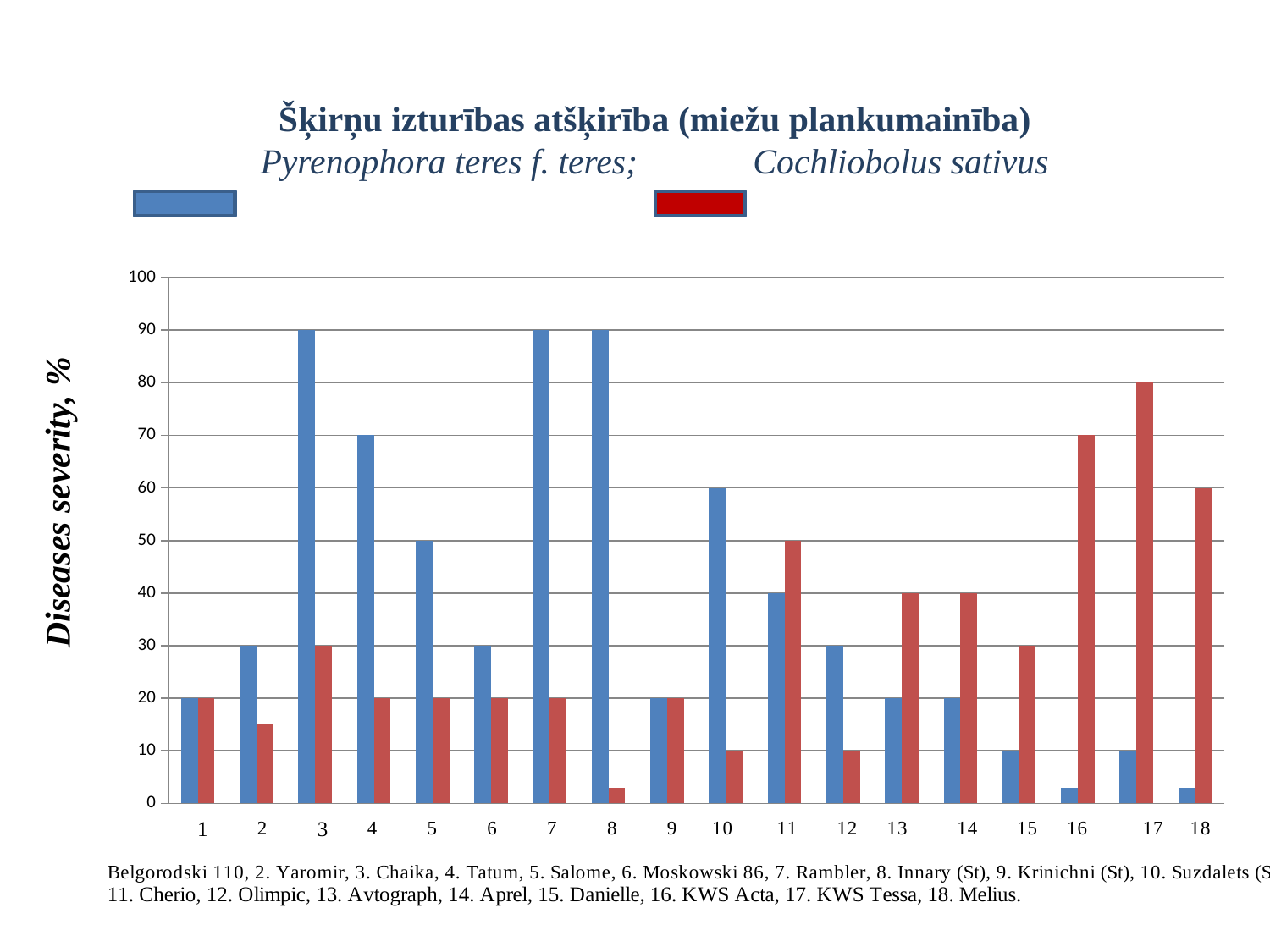
What kind of chart is shown on the slide? bar chart What is the Cochliobolus sativus (red) value for category 17? 80 Is the Pyrenophora teres f. teres (blue) value for category 8 greater or less than 80? greater Which series is shown in red? Cochliobolus sativus For which category is the Cochliobolus sativus (red) value lowest? 8 For which category is the Cochliobolus sativus (red) value highest? 17 How many categories (varieties) are shown on the x axis? 18 What is the Pyrenophora teres f. teres (blue) value for category 4? 70 For category 16, which series has the larger value, Pyrenophora teres f. teres (blue) or Cochliobolus sativus (red)? Cochliobolus sativus What is the label of the y axis? Diseases severity, % How many series does the legend list? 2 For category 4, which series has the larger value, Pyrenophora teres f. teres (blue) or Cochliobolus sativus (red)? Pyrenophora teres f. teres